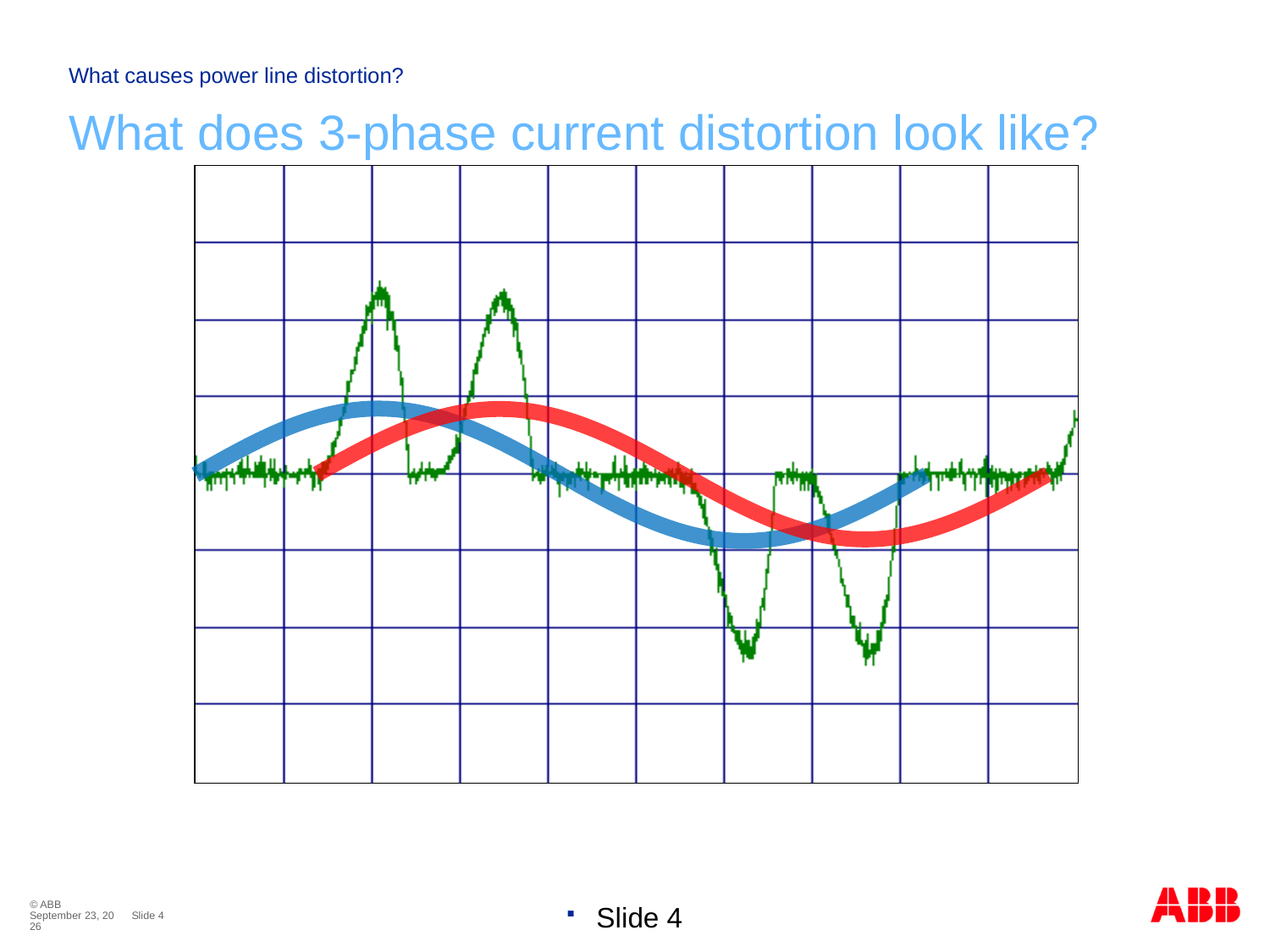
Which coloured trace reaches the highest peak on the chart? green What kind of chart is shown on the slide? line chart What is the title of the slide above the chart? What does 3-phase current distortion look like? Which coloured trace reaches the lowest trough on the chart? green Which trace has the larger peak amplitude, the red trace or the green trace? green What colours are the two smooth sinusoidal traces on the chart? blue and red How many coloured traces are plotted on the chart? 3 Which trace has the larger peak amplitude, the green trace or the blue trace? green